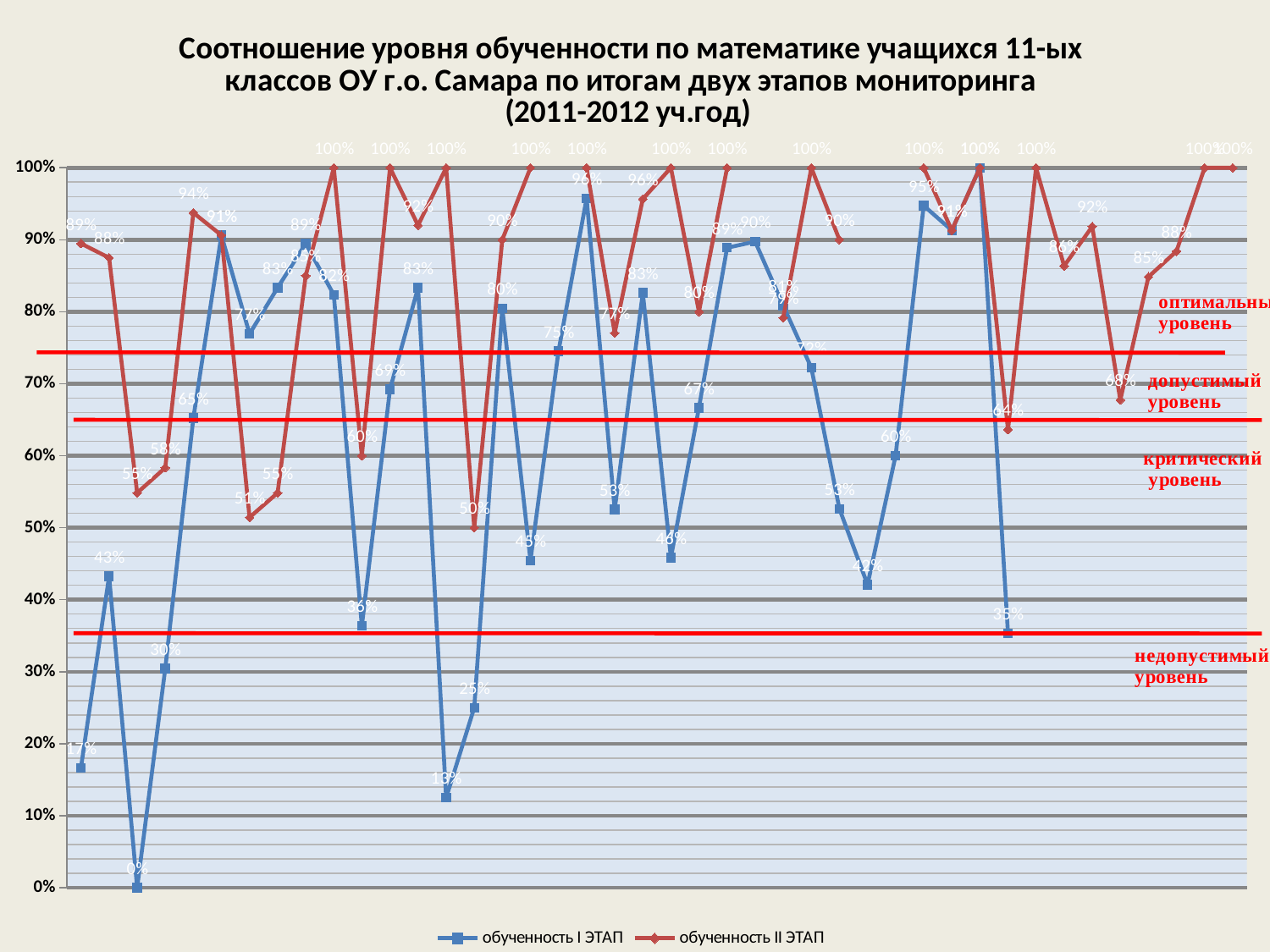
What is the value of the first (leftmost) point of the series обученность II ЭТАП? 89% What is the highest value shown on the vertical axis? 100% What is the value of the first (leftmost) point of the series обученность I ЭТАП? 17% What is the lowest value plotted for the series обученность II ЭТАП? 50% What is the value of the second point from the left of the series обученность I ЭТАП? 43% How many series does the legend list? 2 What is the highest value plotted for the series обученность II ЭТАП? 100% What is the difference between the leftmost values of обученность II ЭТАП (89%) and обученность I ЭТАП (17%)? 72 percentage points What kind of chart is shown on the slide? line chart What is the lowest value plotted for the series обученность I ЭТАП? 0% What are the two series named in the legend? обученность I ЭТАП and обученность II ЭТАП At the leftmost point, which series has the higher value, обученность I ЭТАП or обученность II ЭТАП? обученность II ЭТАП